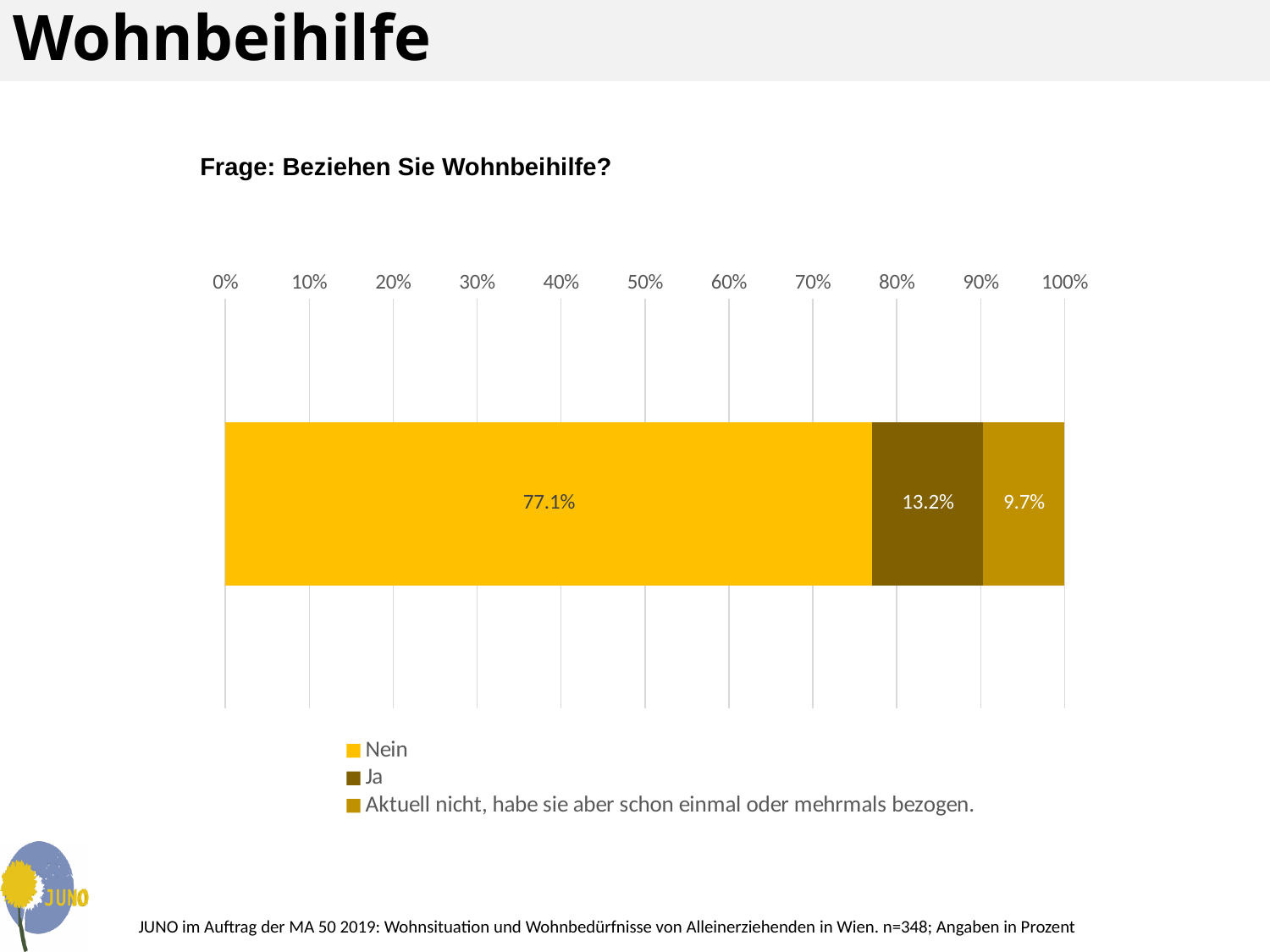
What is the difference in percentage points between the "Nein" and "Ja" segments? 63.9 Which response category has the largest share in the bar? Nein Is the value for "Nein" greater or less than 70%? greater What percentage of respondents chose "Aktuell nicht, habe sie aber schon einmal oder mehrmals bezogen."? 9.7% Which response category has the smallest share in the bar? Aktuell nicht, habe sie aber schon einmal oder mehrmals bezogen. Which is larger, the share for "Ja" or the share for "Aktuell nicht, habe sie aber schon einmal oder mehrmals bezogen."? Ja What is the total of the three segments in the stacked bar? 100.0% What percentage of respondents answered "Nein" to the question about receiving Wohnbeihilfe? 77.1% What kind of chart is shown on the slide? Stacked bar chart What percentage of respondents answered "Ja"? 13.2% What is the difference in percentage points between the "Ja" segment and the "Aktuell nicht, habe sie aber schon einmal oder mehrmals bezogen." segment? 3.5 How many series does the legend list? 3